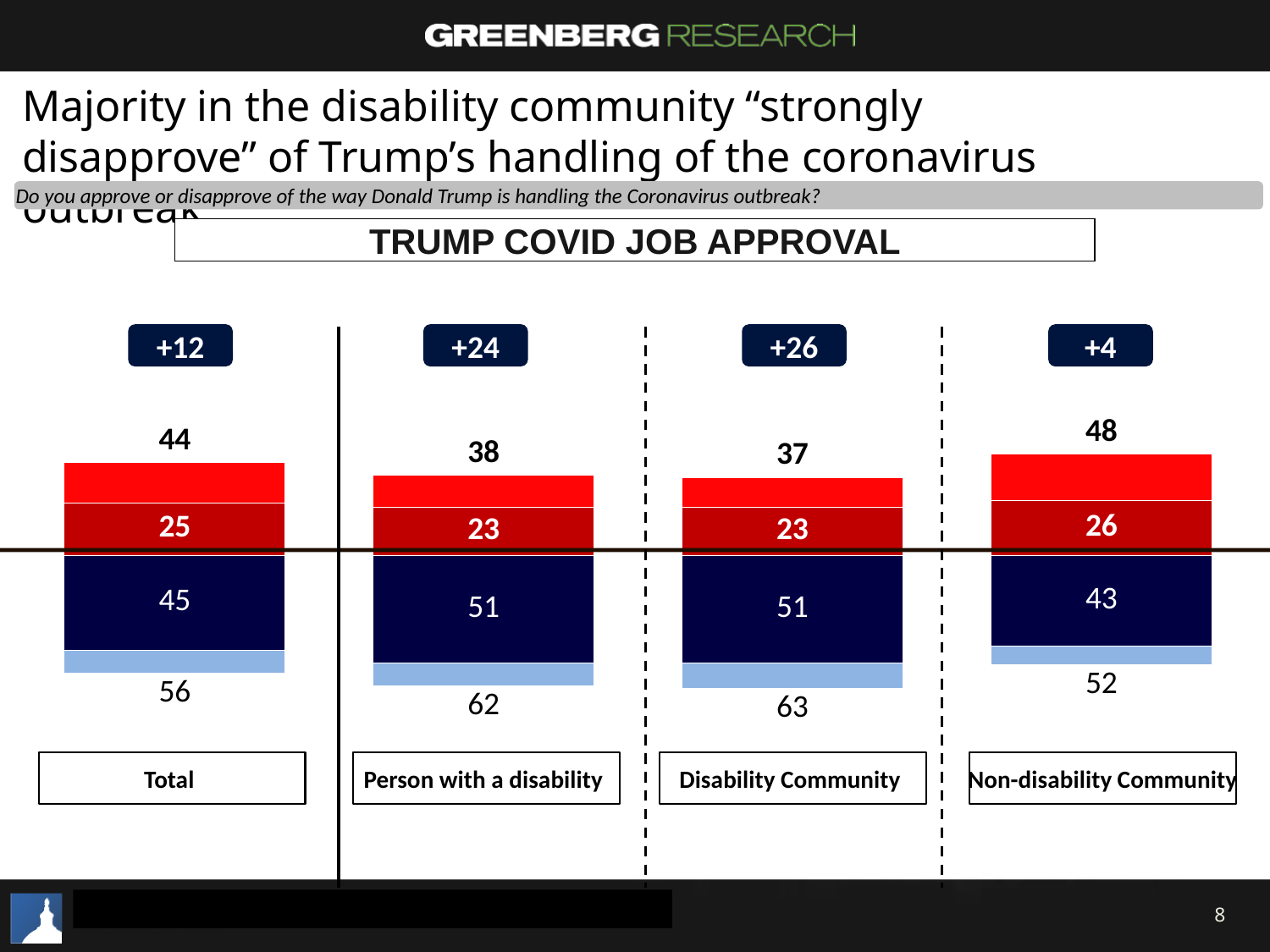
Which is larger: the total approve value for Total or the total approve value for Non-disability Community? Non-disability Community What is the strongly disapprove value (dark blue segment) for Person with a disability? 51 Which category has the lowest total approve value (top number)? Disability Community Which category has the highest total disapprove value (bottom number)? Disability Community What is the total disapprove value (bottom number) for the Disability Community category? 63 What is the strongly approve value (dark red segment) for Non-disability Community? 26 What kind of chart is shown under the title "TRUMP COVID JOB APPROVAL"? bar chart What is the title printed above the chart? TRUMP COVID JOB APPROVAL What net value is shown in the box above the Disability Community bar? +26 How many categories are shown along the bottom of the chart? 4 What is the difference between the total disapprove value for Non-disability Community (52) and the total disapprove value for Disability Community (63)? 11 What is the total approve value (top number) for the Total category? 44